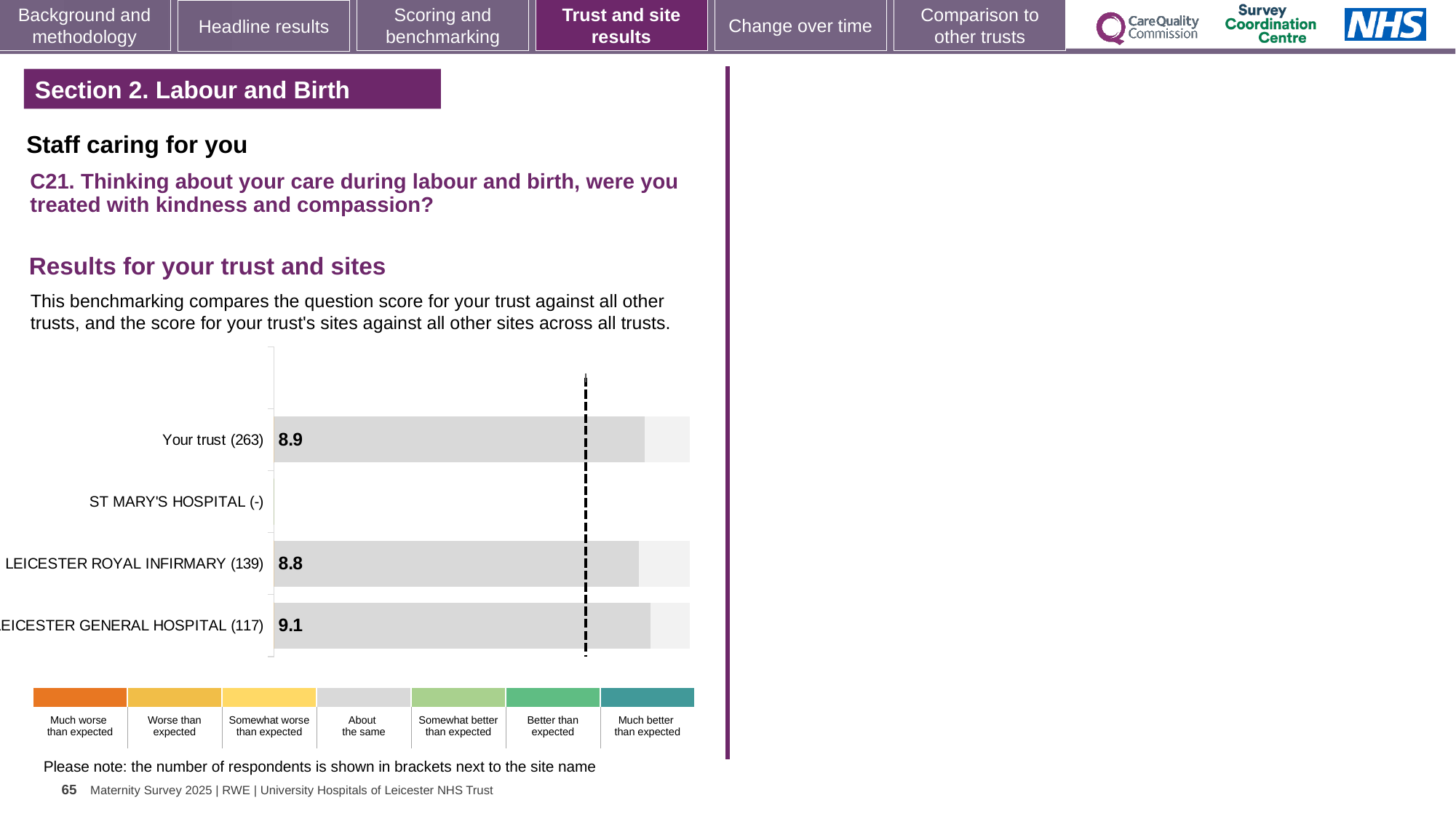
What is the score for Your trust (263)? 8.9 Among the rows with a plotted score, which has the lowest score? LEICESTER ROYAL INFIRMARY (139) How many rating categories are shown in the colour key below the chart? 7 How many respondents are shown in brackets for Your trust? 263 What is the difference between the scores for LEICESTER GENERAL HOSPITAL (117) and LEICESTER ROYAL INFIRMARY (139)? 0.3 Which site has the highest score on the chart? LEICESTER GENERAL HOSPITAL (117) What kind of chart is shown on the slide? Bar chart Which site shows no score bar on the chart? ST MARY'S HOSPITAL (-) Which has the higher score, Your trust (263) or LEICESTER ROYAL INFIRMARY (139)? Your trust (263) What is the score for LEICESTER ROYAL INFIRMARY (139)? 8.8 How many rows (categories) are listed on the chart? 4 What is the score for LEICESTER GENERAL HOSPITAL (117)? 9.1